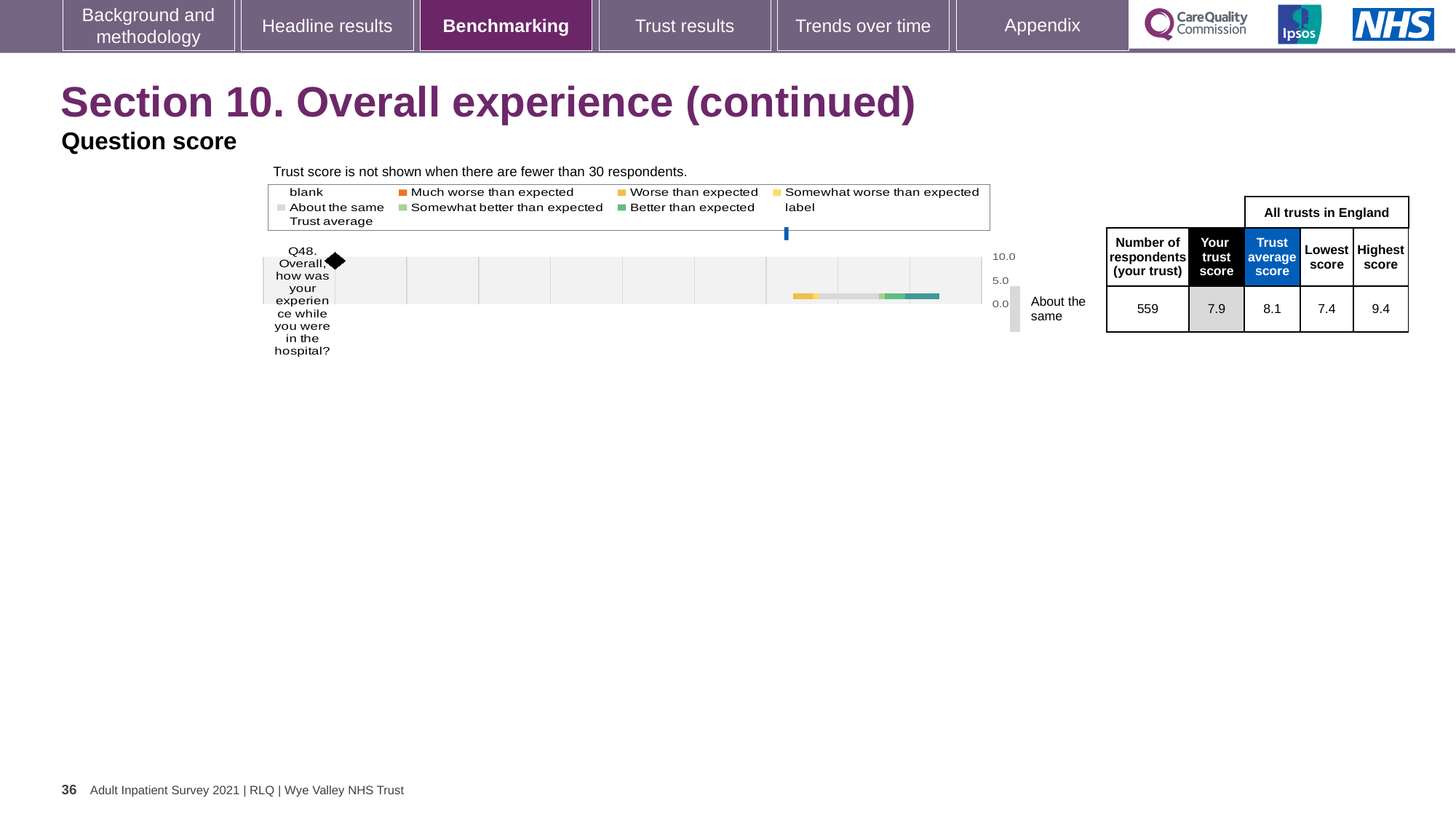
Which is larger for Q48: the trust score or the trust average score? Trust average score What kind of chart is used to show the Q48 benchmarking result? bar chart What is the trust score for Q48 (Overall, how was your experience while you were in the hospital?)? 7.9 How many questions are plotted in the benchmarking chart? 1 What is the difference between the trust average score and the trust score for Q48? 0.2 What is the trust average score for Q48? 8.1 What is the lowest score among all trusts in England for Q48? 7.4 How many respondents from the trust answered Q48? 559 Which benchmark category is Q48 assigned to on the chart? About the same What is the difference between the highest score and the lowest score for Q48? 2.0 What is the maximum value shown on the chart's score axis? 10.0 What is the highest score among all trusts in England for Q48? 9.4